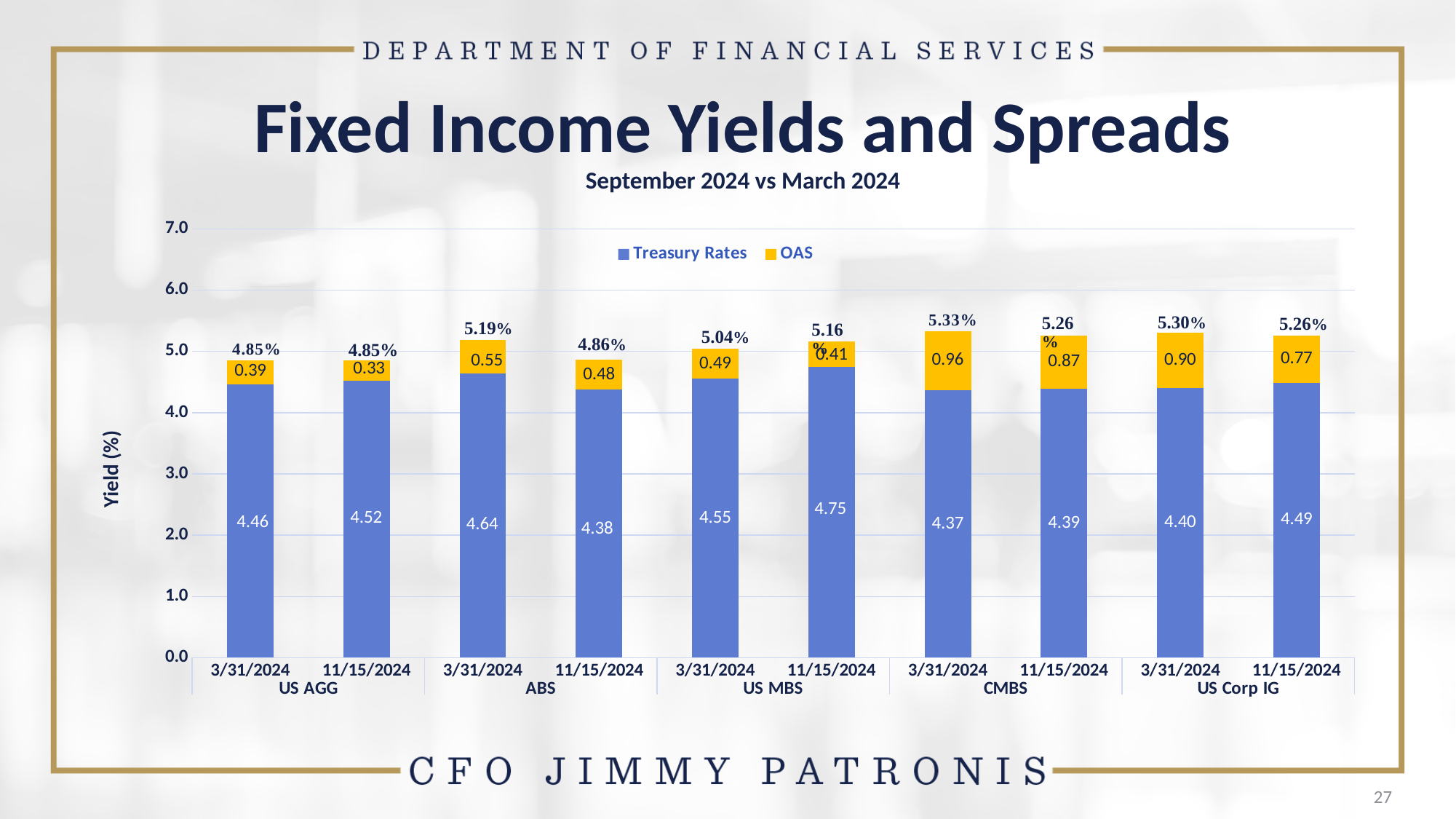
What is the Treasury Rates value for US AGG on 3/31/2024? 4.46 Which is larger, the OAS for US Corp IG on 3/31/2024 or on 11/15/2024? 3/31/2024 (0.90) Is the Treasury Rates value for ABS on 3/31/2024 greater or less than 4.0? greater What are the two series named in the legend? Treasury Rates and OAS Which bar has the lowest OAS value? US AGG 11/15/2024 (0.33) What is the difference between the Treasury Rates values for US MBS on 11/15/2024 and 3/31/2024? 0.20 What kind of chart is shown on the slide? Stacked bar chart How many bars are plotted in the chart? 10 Which bar has the highest total yield? CMBS 3/31/2024 (5.33%) How many series does the legend list? 2 What is the total yield printed above the US MBS bar for 11/15/2024? 5.16% What is the OAS value for CMBS on 3/31/2024? 0.96